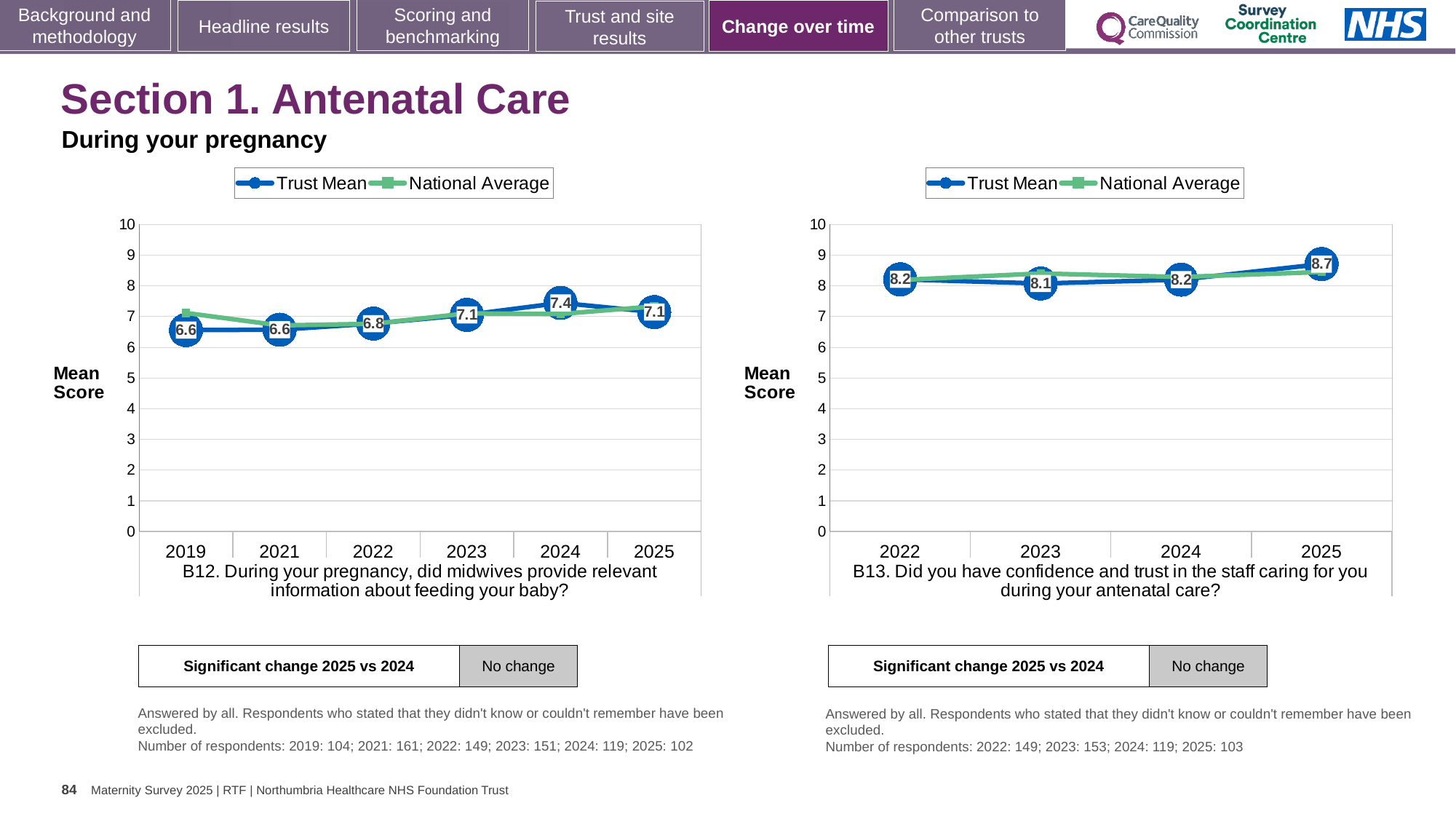
On the B13 chart (right), what is the Trust Mean score for 2025? 8.7 On the B12 chart (left), is the Trust Mean score for 2022 greater or less than 7? less What kind of chart is the B12 chart (left)? Line chart On the B13 chart (right), what is the difference between the Trust Mean scores for 2025 and 2024? 0.5 On the B13 chart (right), is the Trust Mean score for 2025 greater or less than 8? greater How many series does the legend of the B13 chart (right) list? 2 On the B12 chart (left), which year has the highest Trust Mean score? 2024 On the B12 chart (left), what is the difference between the Trust Mean scores for 2024 and 2025? 0.3 On the B12 chart (left), what is the Trust Mean score for 2019? 6.6 On the B13 chart (right), which year has the lowest Trust Mean score? 2023 On the B12 chart (left), what is the Trust Mean score for 2024? 7.4 On the B12 chart (left), how many years are plotted on the x axis? 6